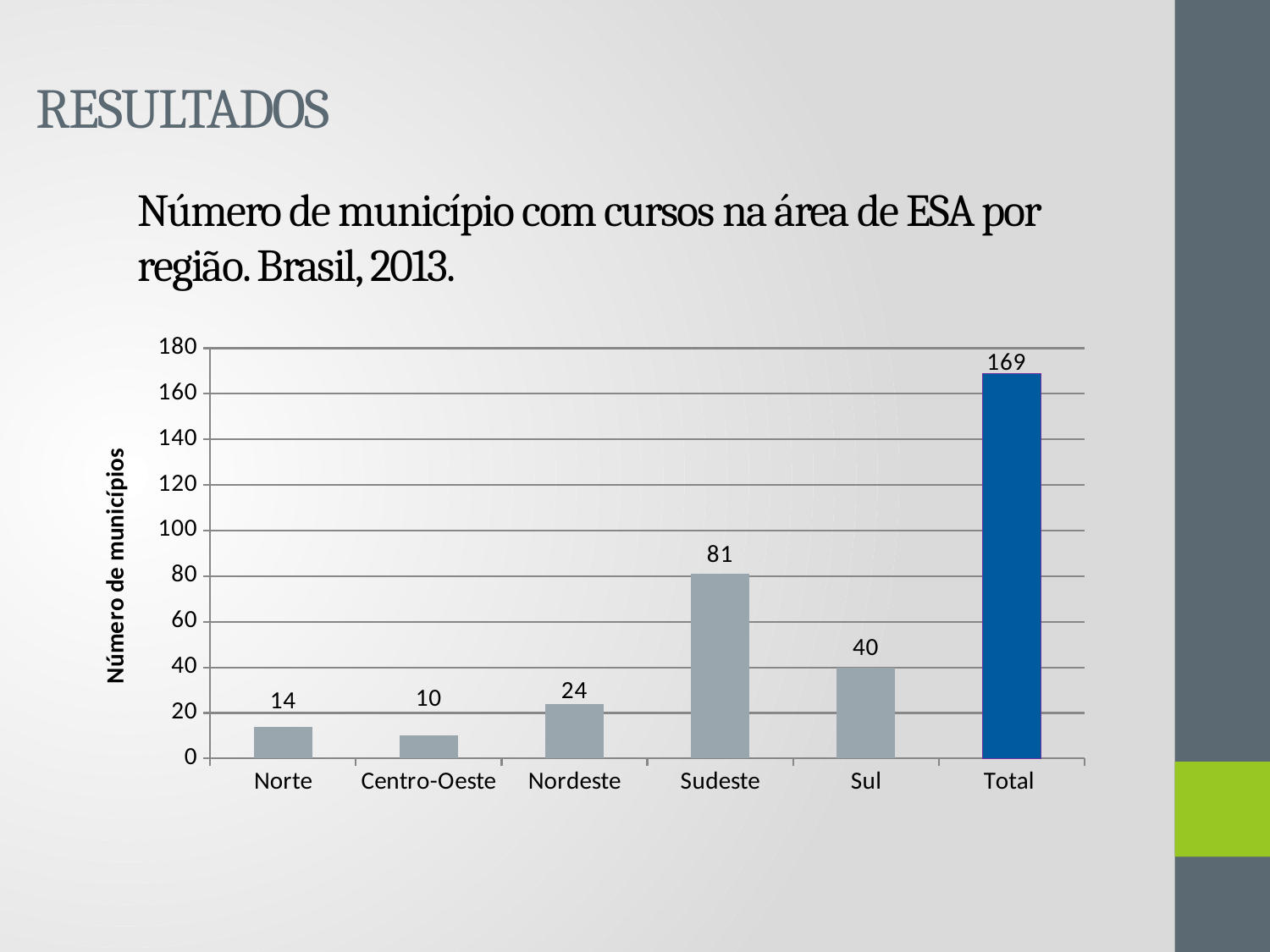
What is the value for Sudeste? 81 What is the label of the vertical axis? Número de municípios Which category has the lowest value? Centro-Oeste What is the value for Total? 169 What is the difference between the values for Nordeste and Norte? 10 What kind of chart is shown on the slide? bar chart Which is larger, the value for Sul or the value for Nordeste? Sul Is the value for Sudeste greater or less than 100? less How many categories are shown on the x axis? 6 What is the difference between the values for Sudeste and Sul? 41 What is the value for Norte? 14 Which region (excluding Total) has the highest number of municipalities? Sudeste